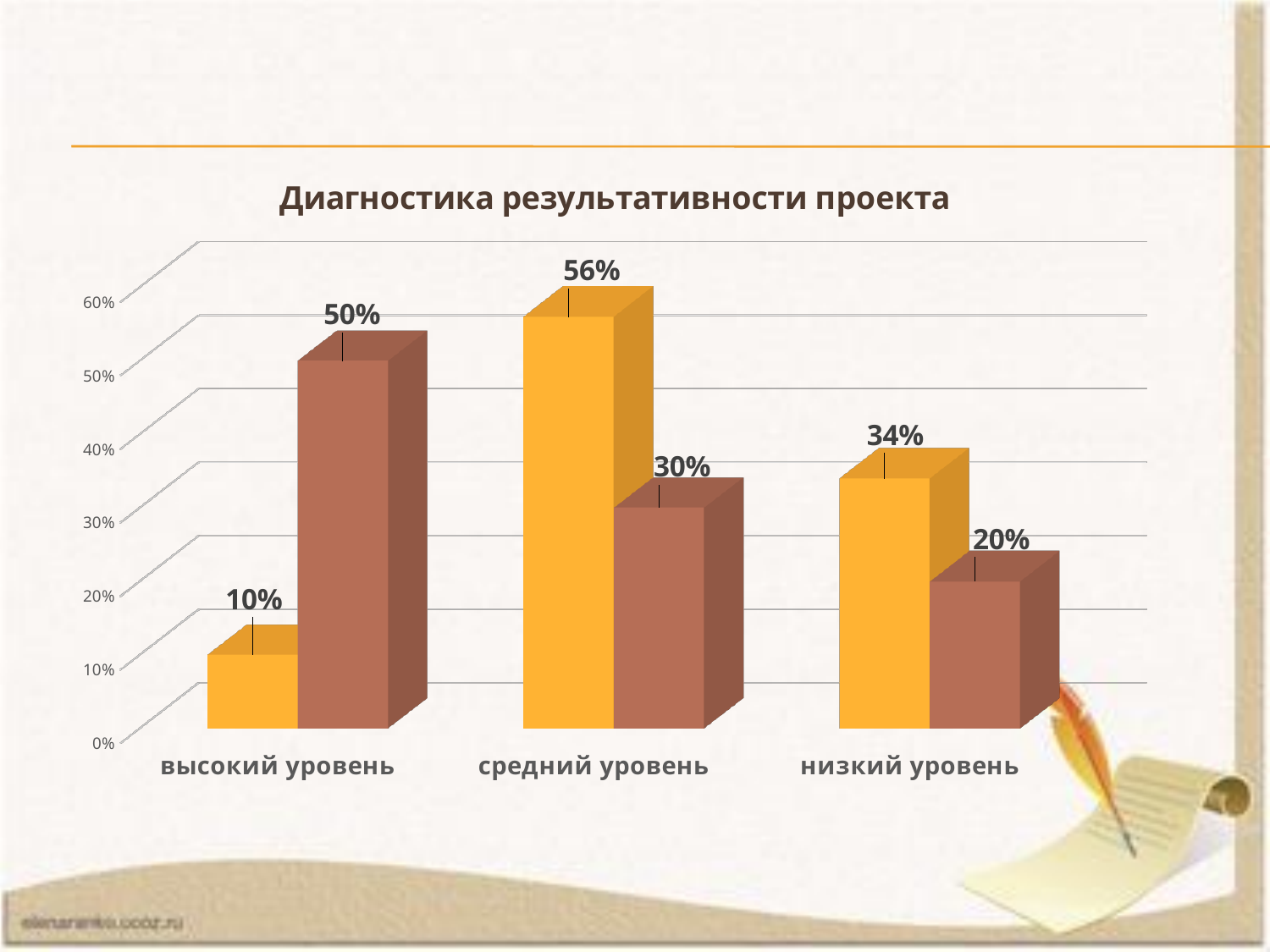
What type of chart is shown on the slide? bar chart Which category has the lowest brown bar? низкий уровень What is the value of the brown bar for 'низкий уровень'? 20% Which category has the highest yellow bar? средний уровень Is the yellow bar for 'низкий уровень' greater or less than 30%? greater What is the title of the chart? Диагностика результативности проекта What is the value of the brown bar for 'высокий уровень'? 50% For 'низкий уровень', which bar is larger, the yellow or the brown one? yellow What is the value of the yellow bar for 'средний уровень'? 56% What is the value of the yellow bar for 'высокий уровень'? 10% What is the difference between the yellow and brown bars for 'средний уровень'? 26% How many categories are shown on the x axis of the chart? 3